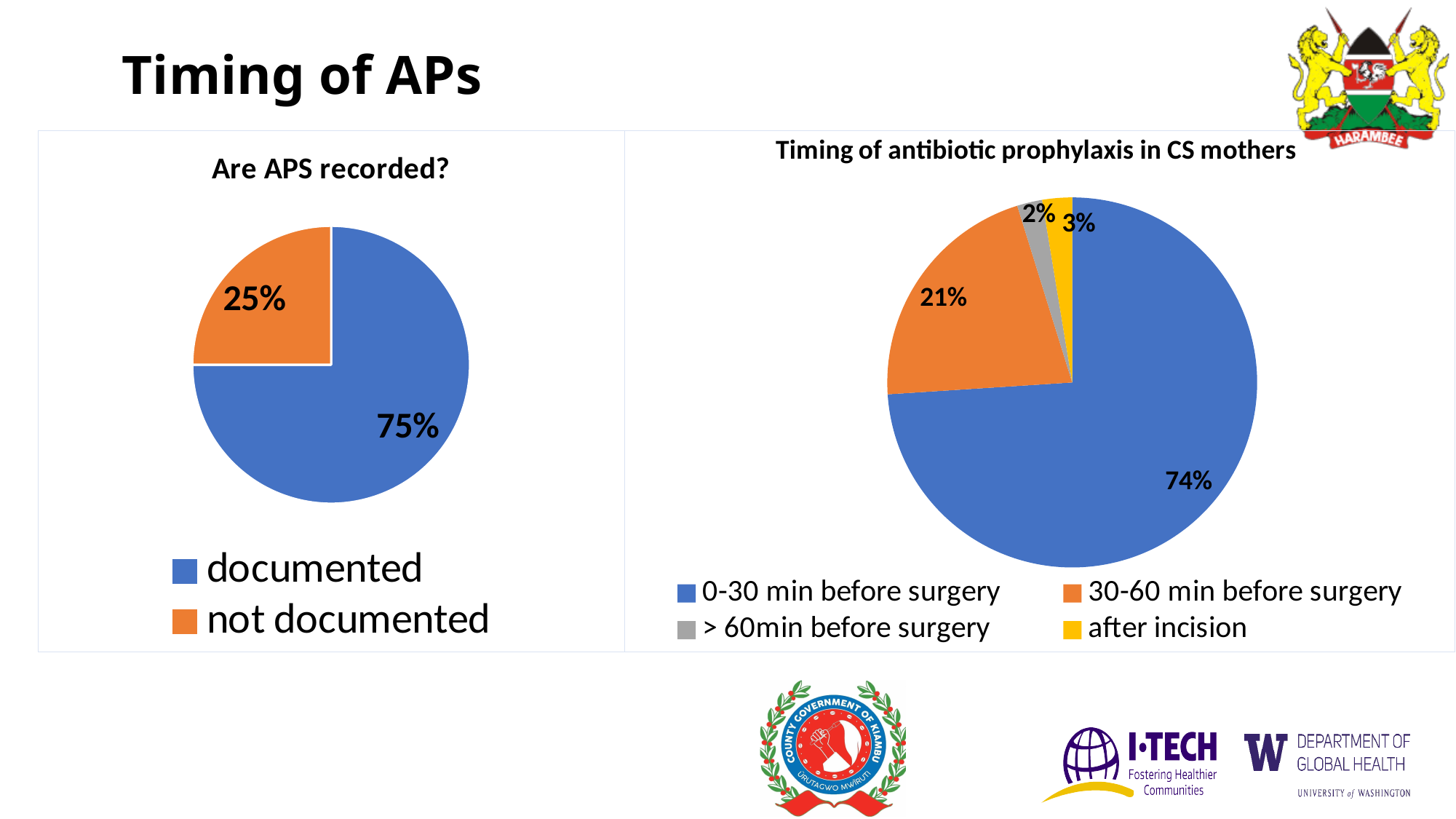
In the 'Timing of antibiotic prophylaxis in CS mothers' chart, how many categories does the legend list? 4 In the 'Timing of antibiotic prophylaxis in CS mothers' chart, what share received prophylaxis 0-30 min before surgery? 74% In the 'Are APS recorded?' chart, what share is not documented? 25% In the 'Timing of antibiotic prophylaxis in CS mothers' chart, which category has the largest share? 0-30 min before surgery In the 'Timing of antibiotic prophylaxis in CS mothers' chart, which category has the smallest share? > 60min before surgery In the 'Are APS recorded?' chart, what is the difference between the documented and not documented shares? 50% In the 'Are APS recorded?' chart, what share is documented? 75% In the 'Timing of antibiotic prophylaxis in CS mothers' chart, what share received prophylaxis 30-60 min before surgery? 21% In the 'Timing of antibiotic prophylaxis in CS mothers' chart, which colour represents 'after incision'? yellow In the 'Are APS recorded?' chart, how many categories does the legend list? 2 In the 'Are APS recorded?' chart, what kind of chart is shown? pie chart In the 'Timing of antibiotic prophylaxis in CS mothers' chart, what share received prophylaxis after incision? 3%